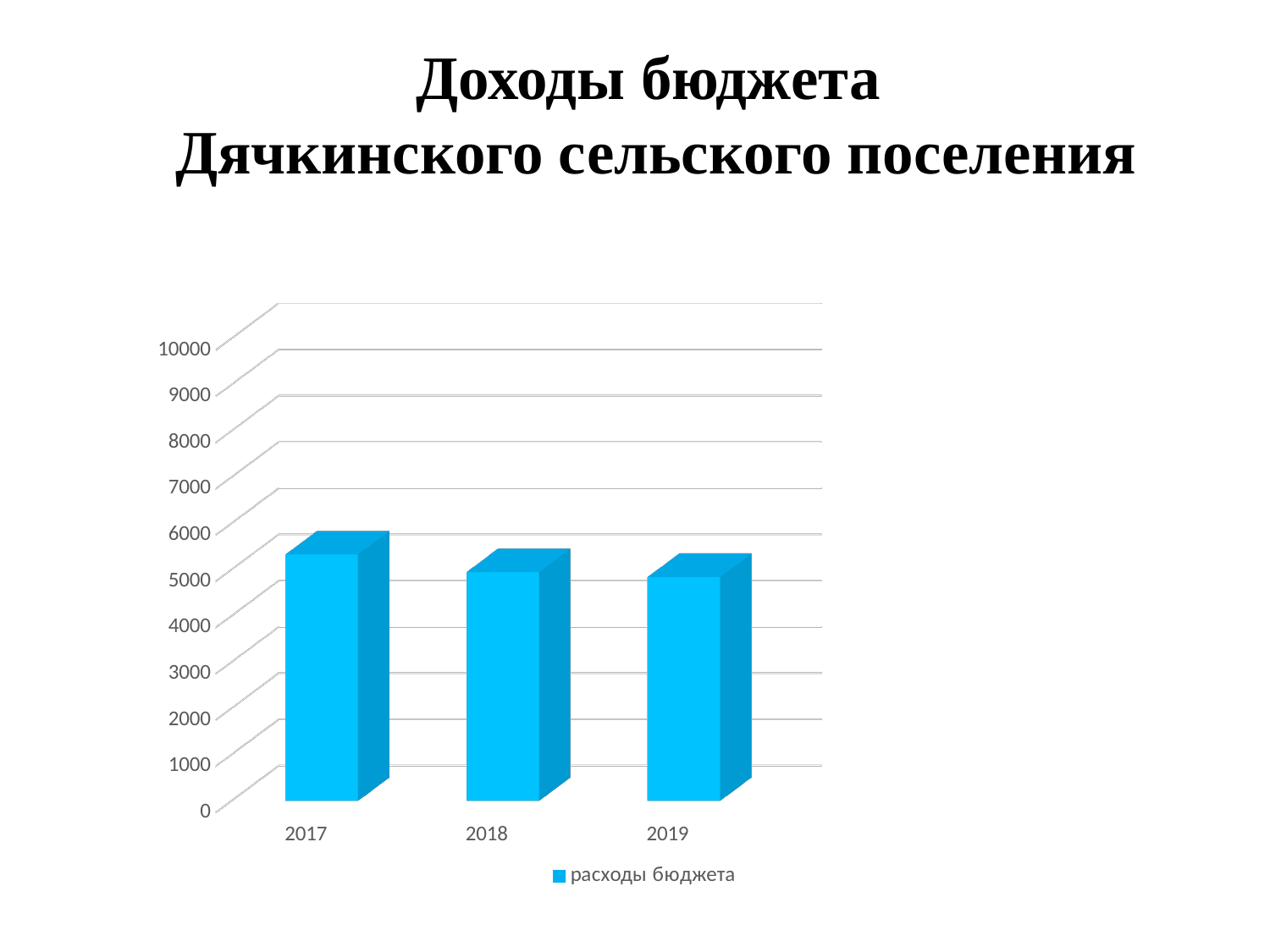
Which year has the highest bar in the chart? 2017 Is the value for 2017 greater or less than 6000? less How many years are shown on the x axis of the chart? 3 Which is larger, the value for 2017 or the value for 2019? 2017 Do the values rise or fall from 2017 to 2019? fall What is the title of the slide containing the chart? Доходы бюджета Дячкинского сельского поселения What kind of chart is shown on the slide? bar chart Is the value for 2018 greater or less than 6000? less How many series does the chart legend list? 1 Is the value for 2019 greater or less than 4000? greater What is the name of the series shown in the chart legend? расходы бюджета